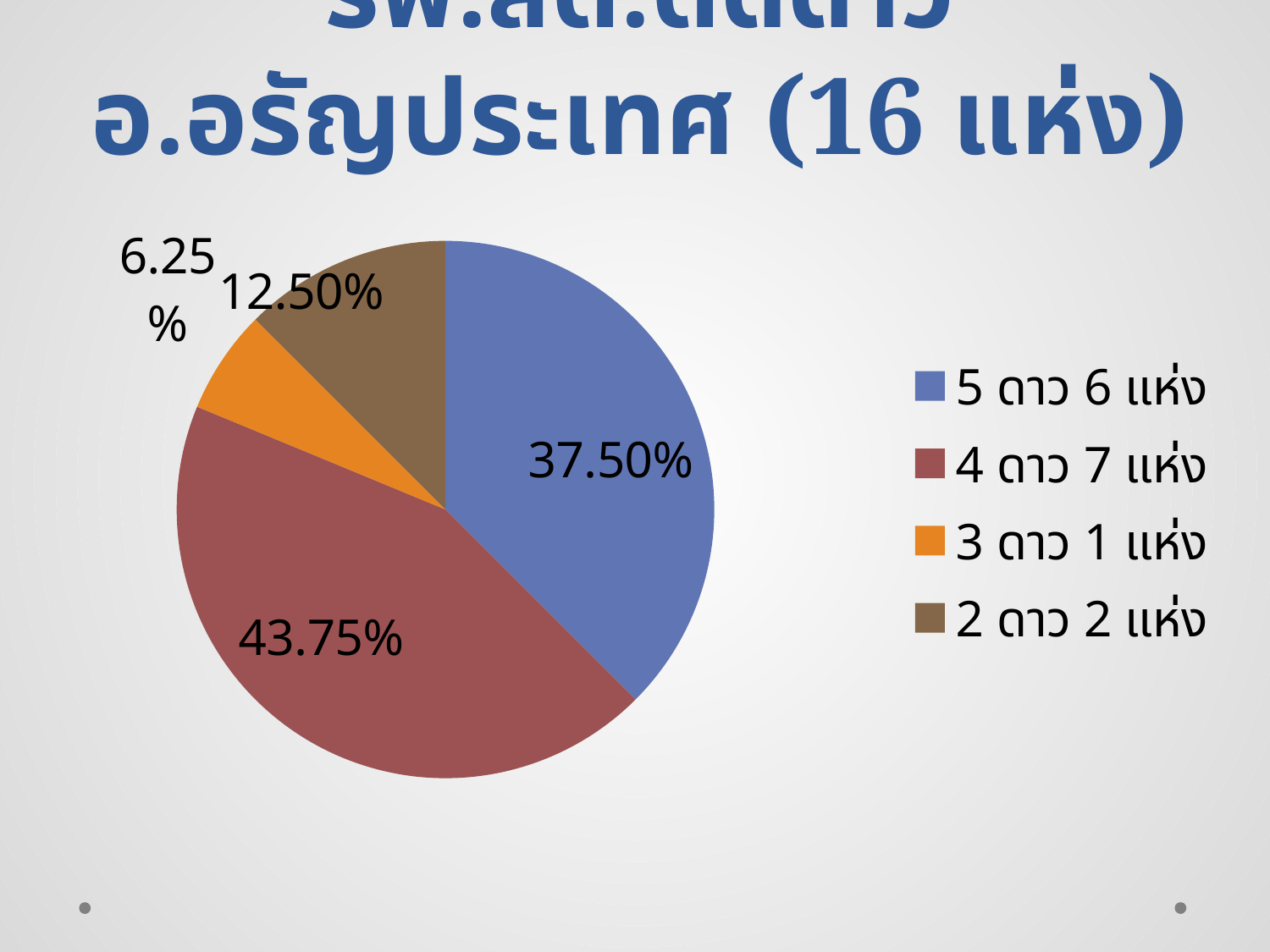
Which slice is larger: 2 ดาว 2 แห่ง or 3 ดาว 1 แห่ง? 2 ดาว 2 แห่ง What colour is the slice for 3 ดาว 1 แห่ง? Orange What percentage of the pie is the slice for 4 ดาว 7 แห่ง? 43.75% What percentage of the pie is the slice for 5 ดาว 6 แห่ง? 37.50% What is the difference in percentage points between the 4 ดาว 7 แห่ง slice and the 5 ดาว 6 แห่ง slice? 6.25 What type of chart is shown on the slide? Pie chart What percentage of the pie is the slice for 2 ดาว 2 แห่ง? 12.50% How many categories does the pie chart have? 4 How many แห่ง in total does the chart title state? 16 Which category has the smallest slice of the pie? 3 ดาว 1 แห่ง What percentage of the pie is the slice for 3 ดาว 1 แห่ง? 6.25% Which category has the largest slice of the pie? 4 ดาว 7 แห่ง